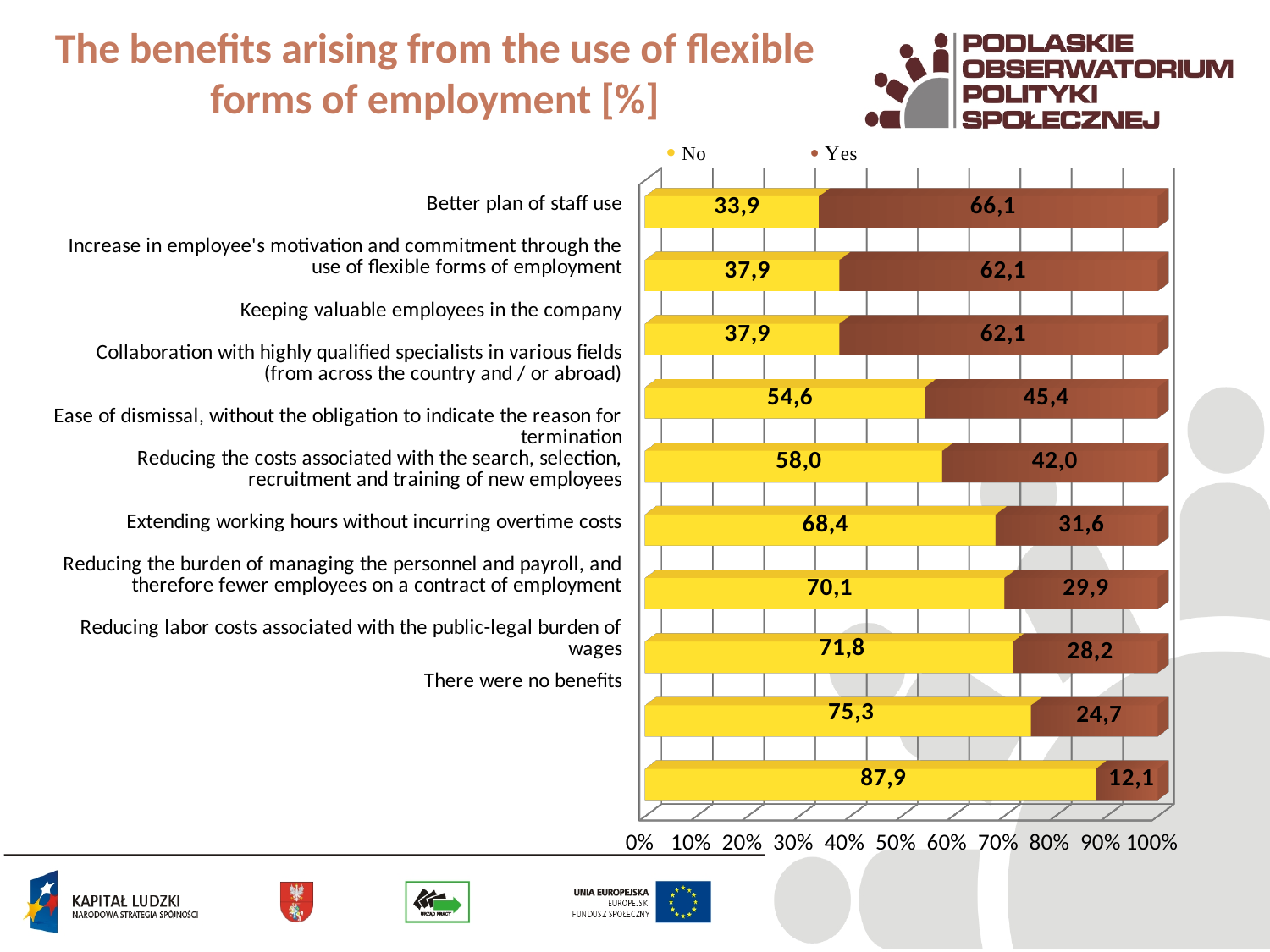
How many categories (bars) are plotted in the chart? 10 What is the 'Yes' value for 'Better plan of staff use'? 66,1 Which category has the lowest 'Yes' value? There were no benefits How many series does the legend list? 2 What is the 'Yes' value for 'Extending working hours without incurring overtime costs'? 29,9 Which colour represents the 'Yes' series in the chart? brown What is the difference between the 'No' and 'Yes' values for 'Better plan of staff use'? 32,2 What is the 'No' value for 'There were no benefits'? 87,9 Which category has the highest 'Yes' value? Better plan of staff use What kind of chart is shown on the slide? stacked bar chart Which is larger for 'Collaboration with highly qualified specialists in various fields': the 'No' value or the 'Yes' value? No What is the total of the 'No' and 'Yes' values for 'Keeping valuable employees in the company'? 100,0